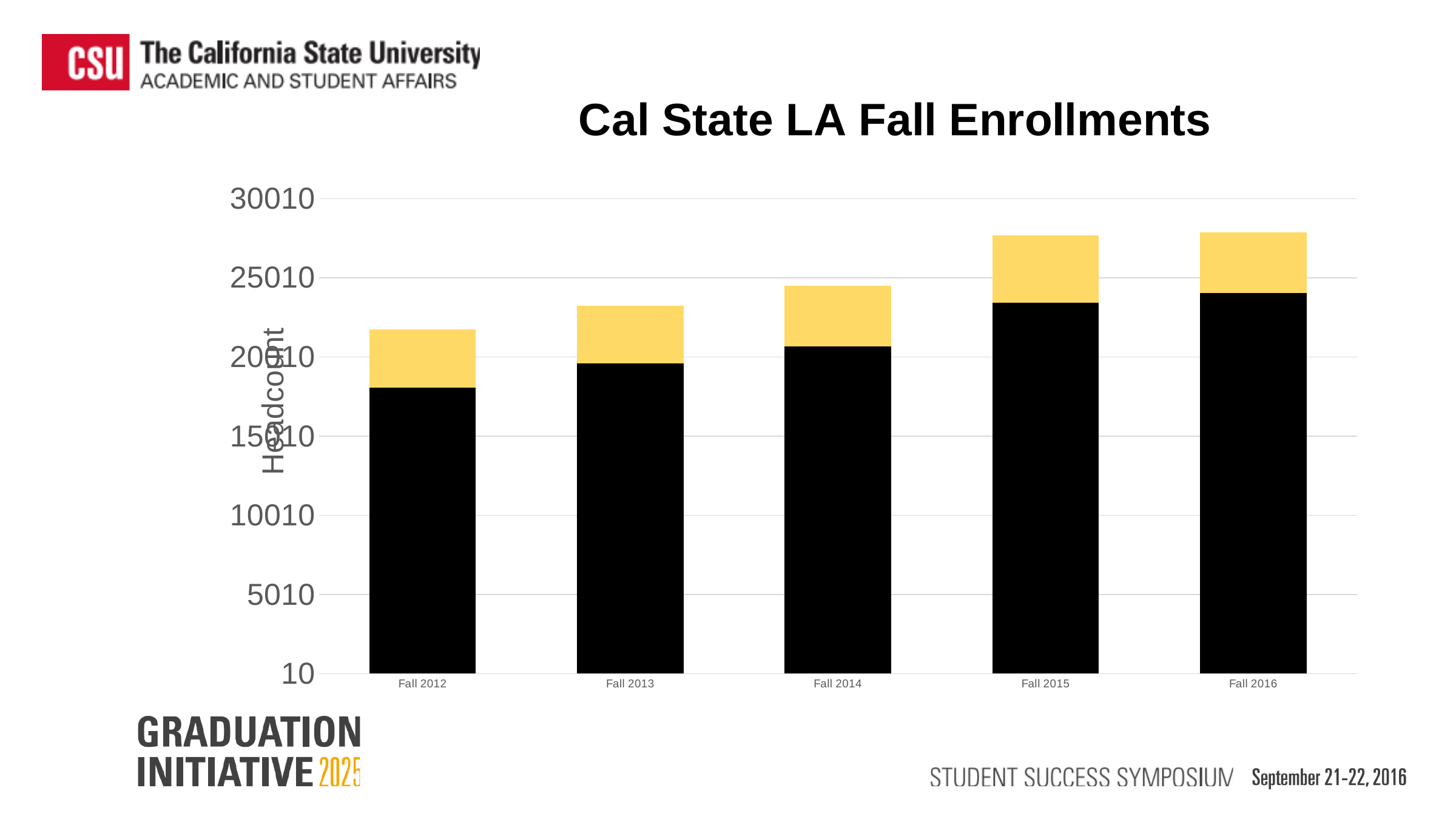
What is the label on the vertical axis of the chart? Headcount Which has the larger total headcount, Fall 2013 or Fall 2015? Fall 2015 Which has the larger black segment, Fall 2012 or Fall 2014? Fall 2014 What kind of chart is shown on the slide? Stacked bar chart Is the total headcount for Fall 2012 greater or less than 25010? less What is the title of the chart? Cal State LA Fall Enrollments Do the total headcounts rise or fall from Fall 2012 to Fall 2016? Rise Is the total headcount for Fall 2016 greater or less than 25010? greater Is the black segment for Fall 2015 greater or less than 20010? greater Which fall term has the lowest total headcount? Fall 2012 How many fall terms are shown on the x axis of the chart? 5